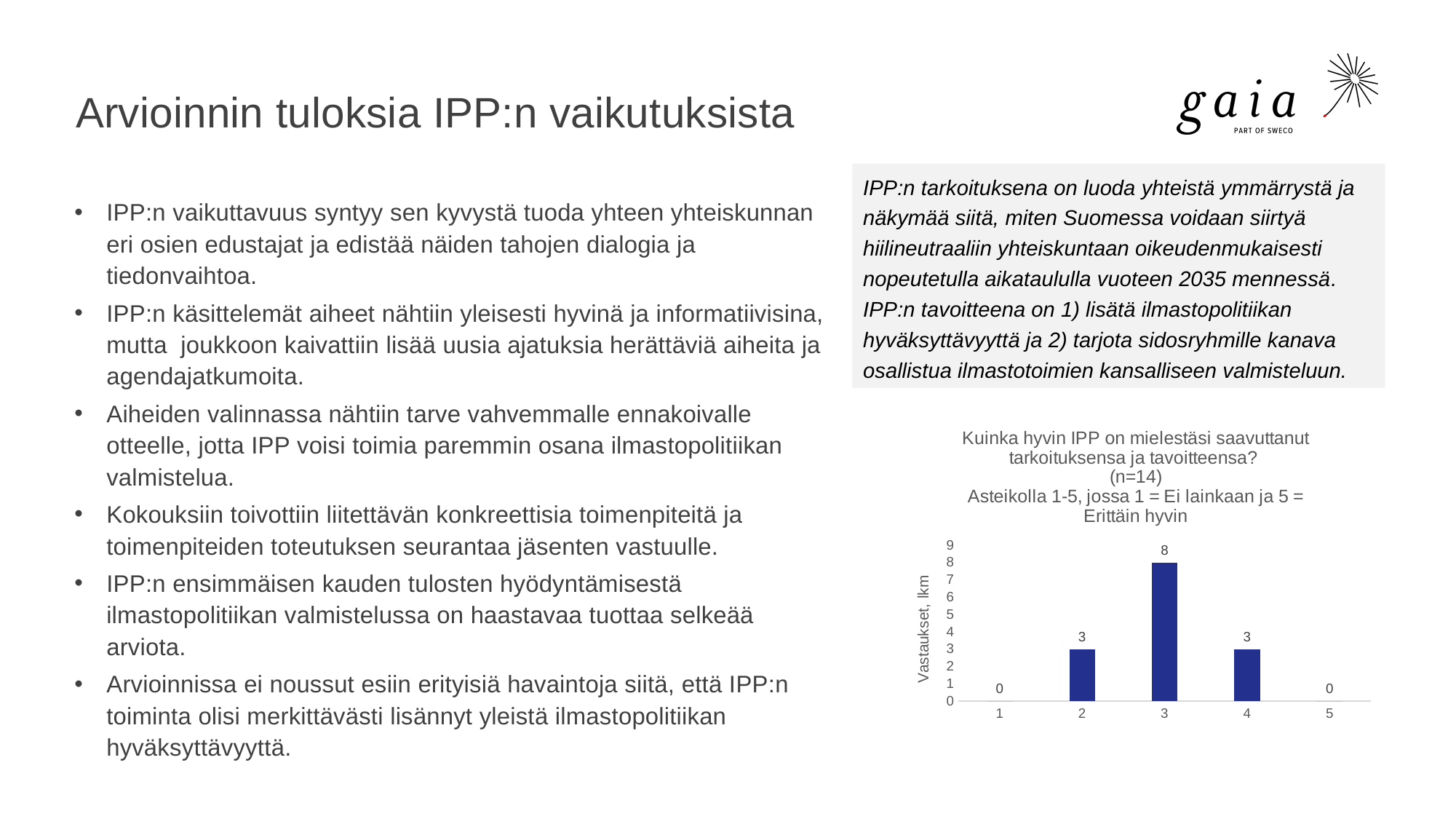
Is the value for rating 3 greater or less than 7? greater How many responses are shown for rating 3? 8 How many rating categories are shown on the x axis? 5 Which rating received the most responses? 3 What is the difference between the number of responses for rating 3 and rating 4? 5 What kind of chart is shown on the slide? bar chart What is the label of the y axis of the chart? Vastaukset, lkm Which has more responses, rating 2 or rating 3? 3 How many responses are shown for rating 2? 3 What sample size (n) is stated in the chart title? n=14 What is the total number of responses across all ratings? 14 How many responses are shown for rating 5? 0